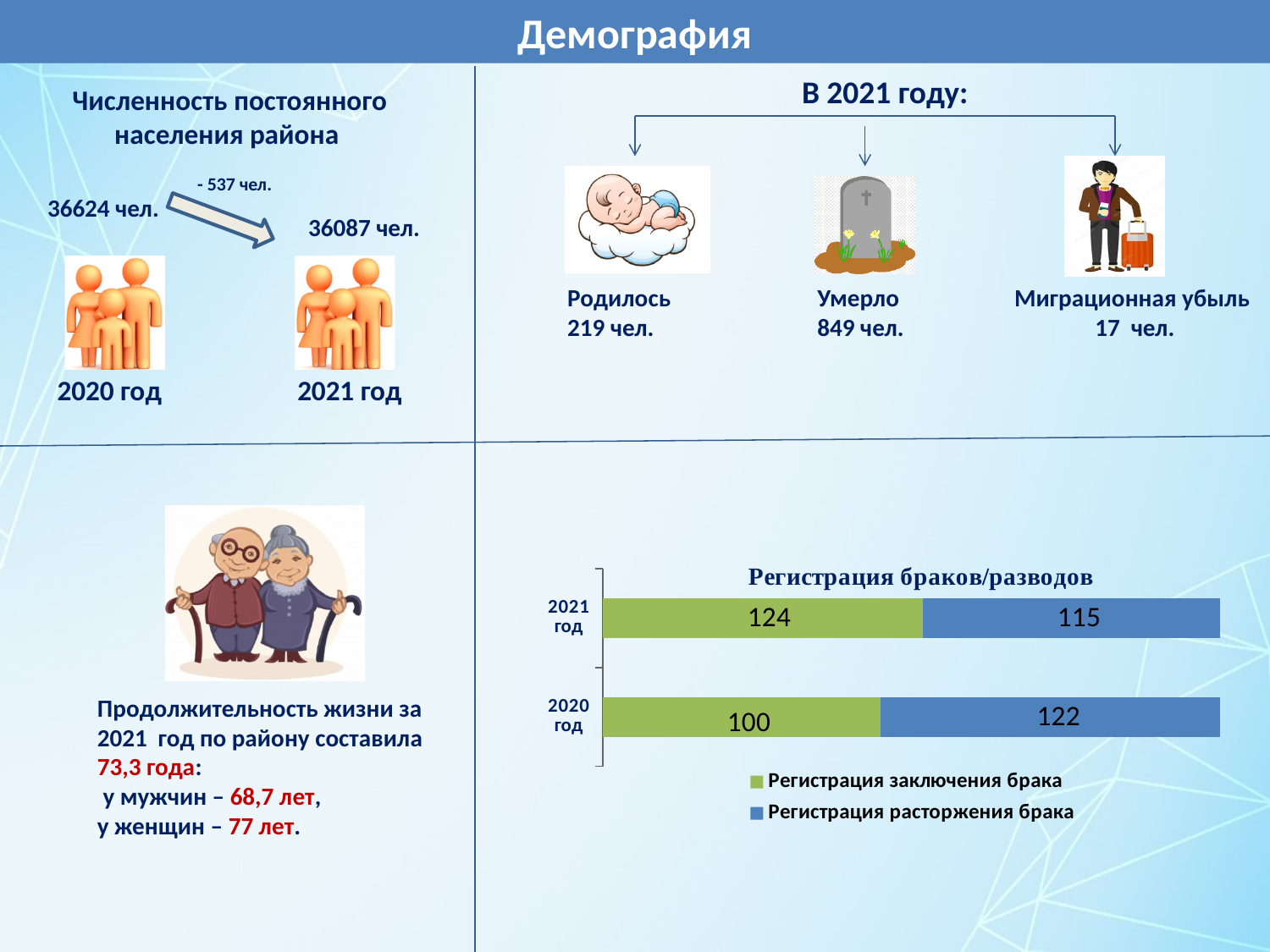
What is the total of the stacked bar for 2020 год? 222 By how much did "Регистрация заключения брака" change from 2020 год to 2021 год? 24 What is the total of the stacked bar for 2021 год? 239 How many categories (years) are shown in the "Регистрация браков/разводов" chart? 2 What is the value of "Регистрация расторжения брака" for 2020 год? 122 What is the value of "Регистрация расторжения брака" for 2021 год? 115 What is the value of "Регистрация заключения брака" for 2020 год? 100 Which year has the higher value for "Регистрация заключения брака", 2020 год or 2021 год? 2021 год What is the title of the chart on the slide? Регистрация браков/разводов How many series does the legend of the "Регистрация браков/разводов" chart list? 2 What is the value of "Регистрация заключения брака" for 2021 год? 124 What kind of chart is "Регистрация браков/разводов"? stacked bar chart